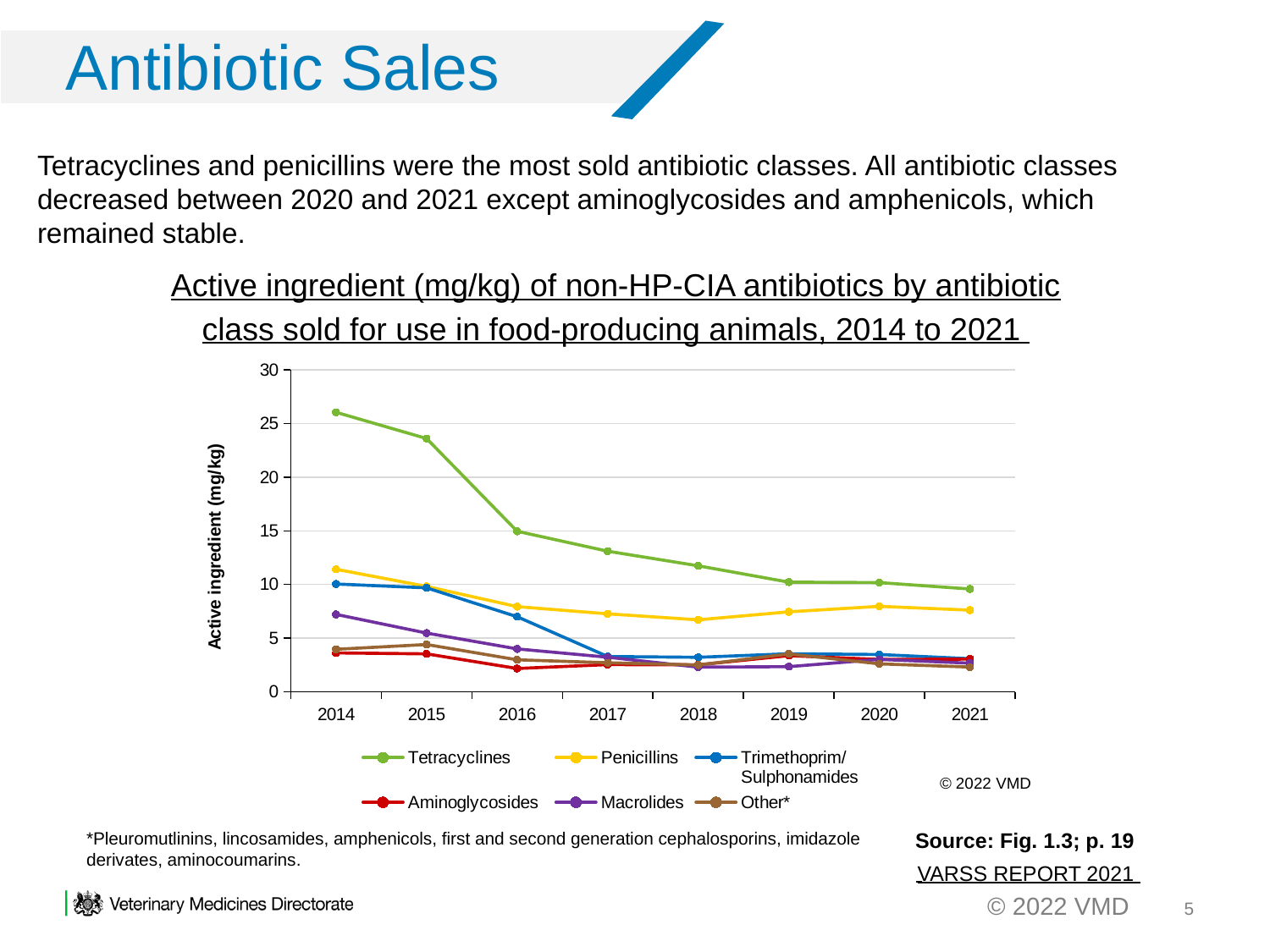
What kind of chart is shown on the slide? Line chart Which antibiotic class had the lowest active ingredient value in 2016? Aminoglycosides Do the values for Tetracyclines rise or fall from 2014 to 2021? Fall Is the value for Tetracyclines in 2017 greater or less than 15? less Is the value for Tetracyclines in 2014 greater or less than 20? greater In 2021, which is larger: the value for Tetracyclines or the value for Penicillins? Tetracyclines Is the value for Penicillins in 2014 greater or less than 10? greater Which antibiotic class had the highest active ingredient value in 2014? Tetracyclines What is the label on the y axis of the chart? Active ingredient (mg/kg) How many years are plotted along the x axis of the chart? 8 How many series does the chart legend list? 6